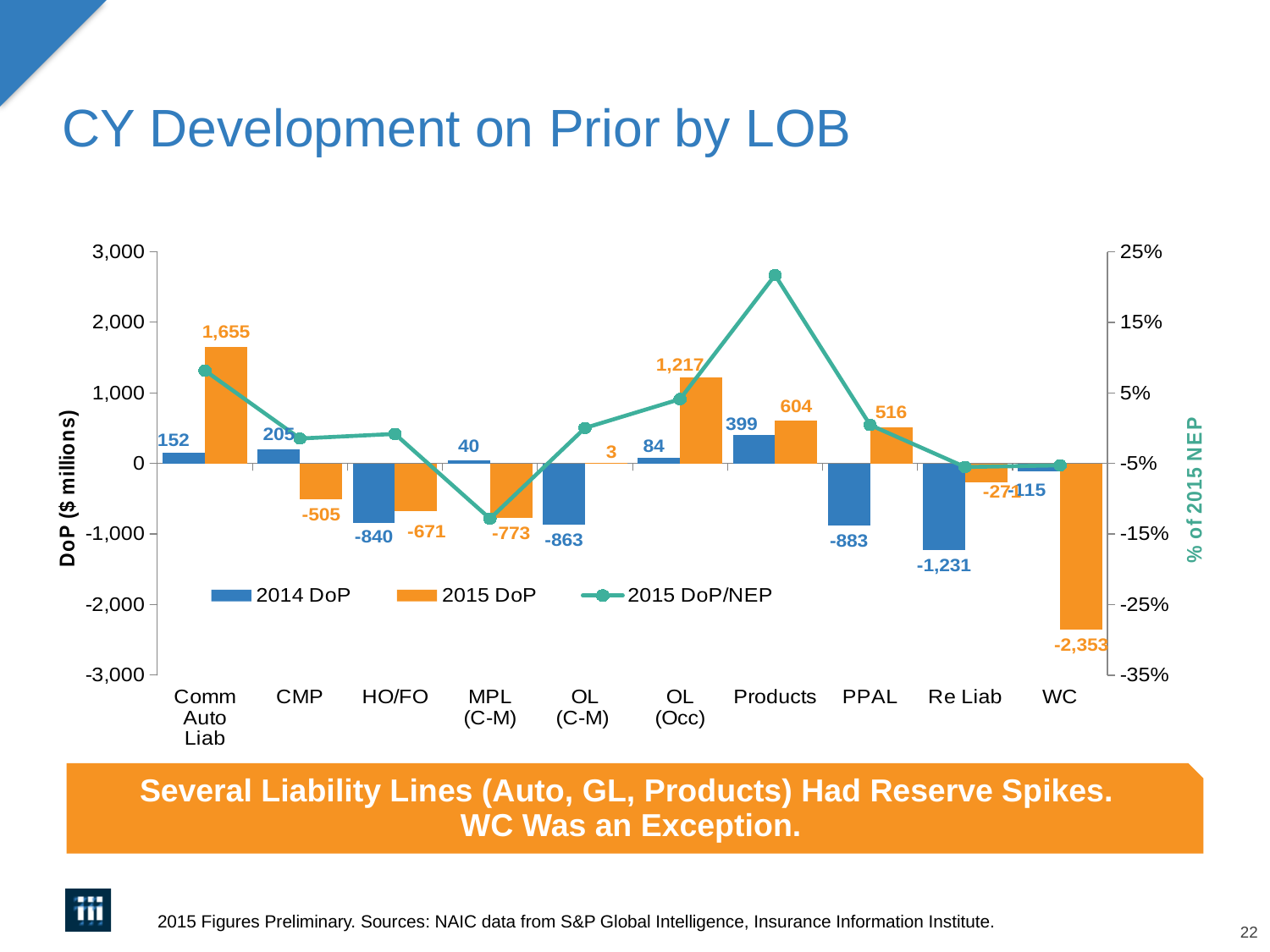
Is the 2015 DoP/NEP value for Products greater or less than 15%? greater How many series does the legend list? 3 What is the 2015 DoP value for MPL (C-M)? -773 Which line of business has the highest 2014 DoP? Products What is the 2014 DoP value for HO/FO? -840 Which line of business has the highest 2015 DoP? Comm Auto Liab What is the difference between the 2015 DoP and 2014 DoP for Products? 205 What is the 2015 DoP value for Comm Auto Liab? 1,655 Which line of business has the lowest 2015 DoP? WC How many lines of business are shown on the x axis? 10 Which is larger, the 2015 DoP for OL (Occ) or for Products? OL (Occ) Which line of business has the lowest 2014 DoP? Re Liab